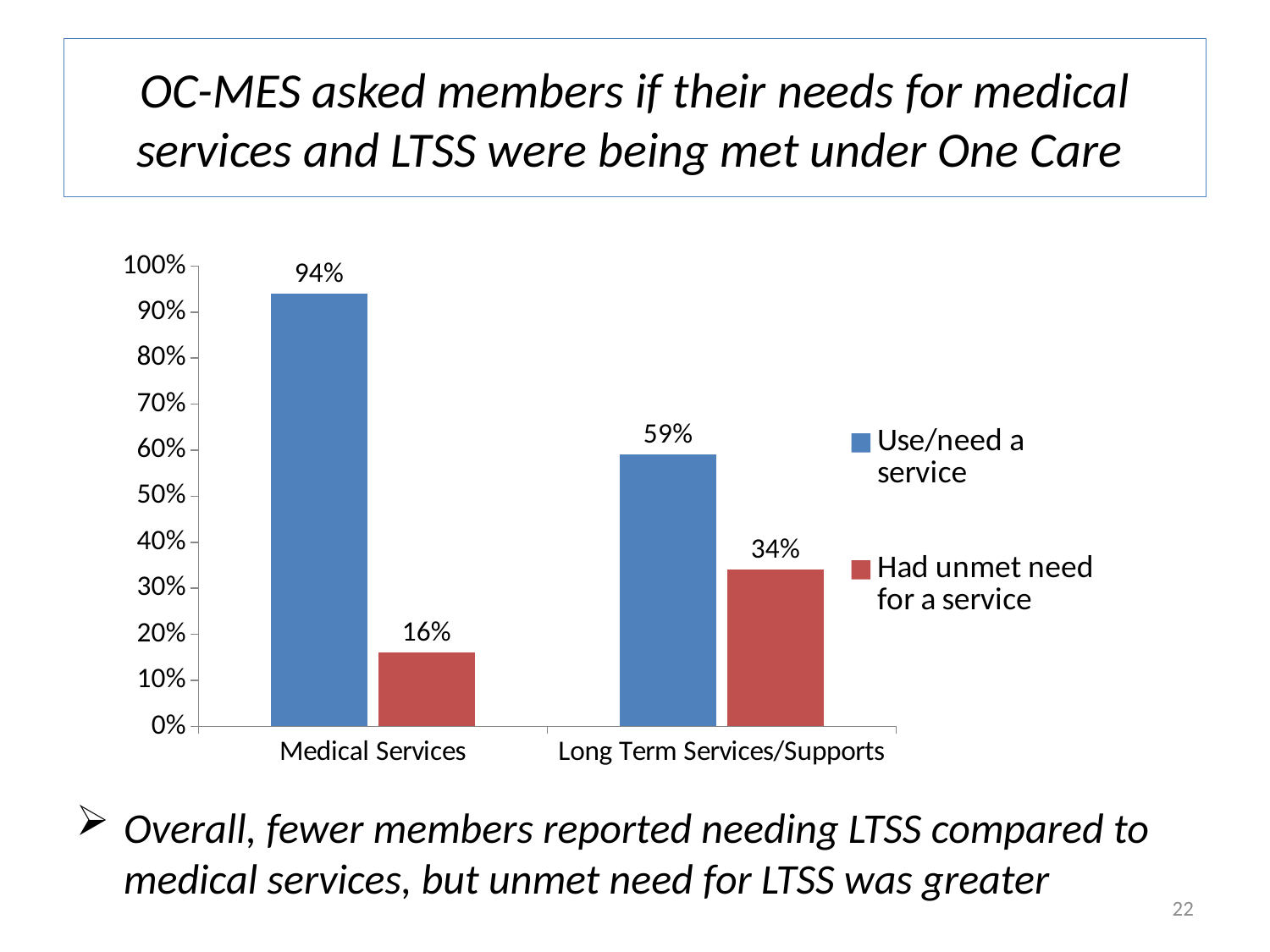
What is the difference between the 'Use/need a service' values for Medical Services and Long Term Services/Supports? 35% Which category has the higher value for 'Use/need a service'? Medical Services What percentage of members had an unmet need for Medical Services? 16% How many series does the chart legend list? 2 What is the difference between the 'Had unmet need for a service' values for Long Term Services/Supports and Medical Services? 18% How many categories are shown on the x axis of the chart? 2 Which category has the lower value for 'Had unmet need for a service'? Medical Services What percentage of members had an unmet need for Long Term Services/Supports? 34% What percentage of members reported using or needing Long Term Services/Supports? 59% What percentage of members reported using or needing Medical Services? 94% Is the unmet need for Long Term Services/Supports larger or smaller than the unmet need for Medical Services? larger What type of chart is shown on the slide? bar chart